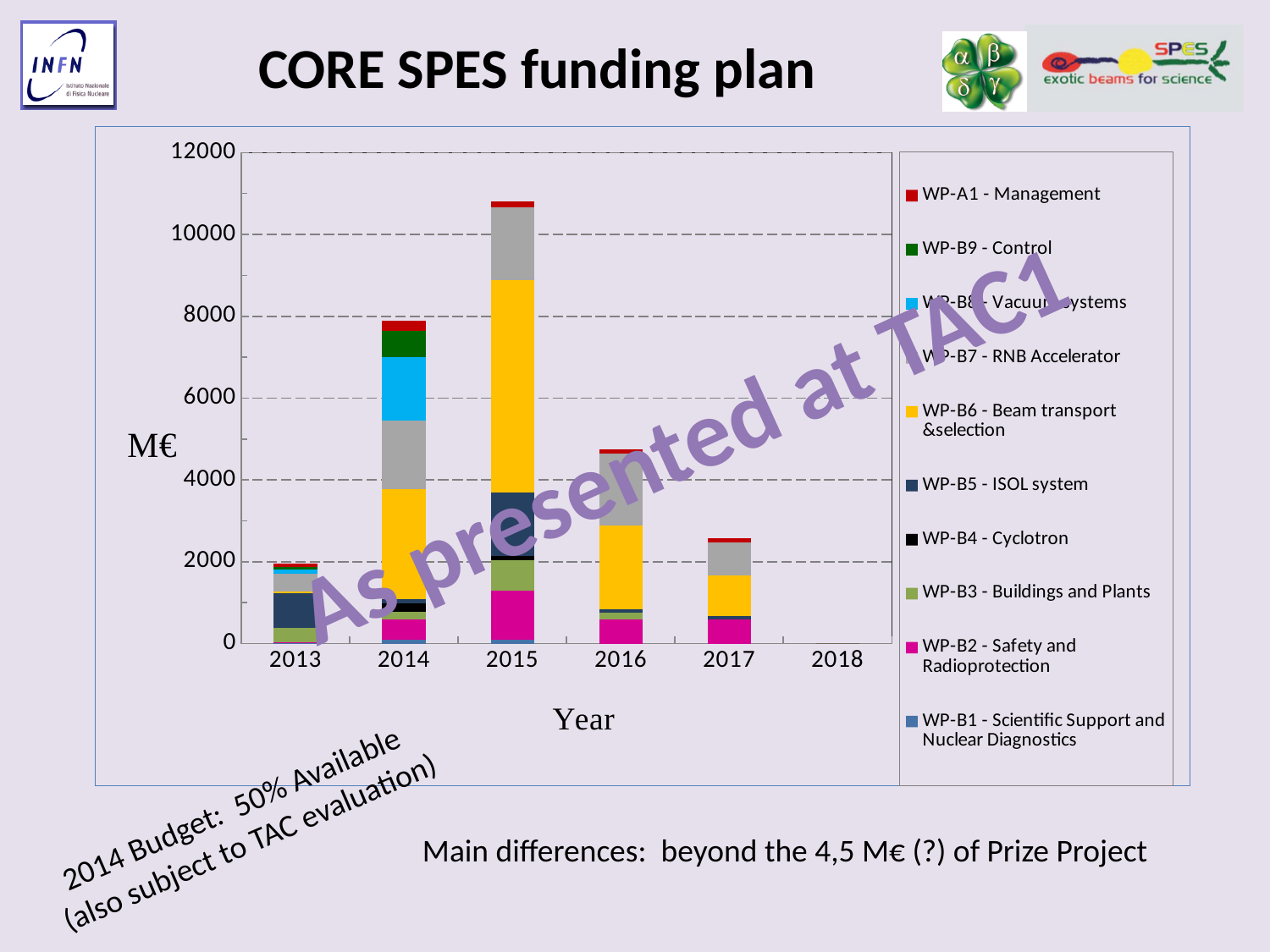
What kind of chart is shown on the slide? Stacked bar chart How many years are shown on the x axis? 6 Is the total for 2016 greater or less than 4000? greater What is the label on the y axis of the chart? M€ Which year has the larger total bar, 2016 or 2017? 2016 Which year has the larger total bar, 2014 or 2016? 2014 Is the total for 2014 greater or less than 6000? greater How many series does the legend list? 10 Is the total for 2015 greater or less than 10000? greater Which year has the highest total funding bar? 2015 Which legend entry is shown in yellow? WP-B6 - Beam transport &selection